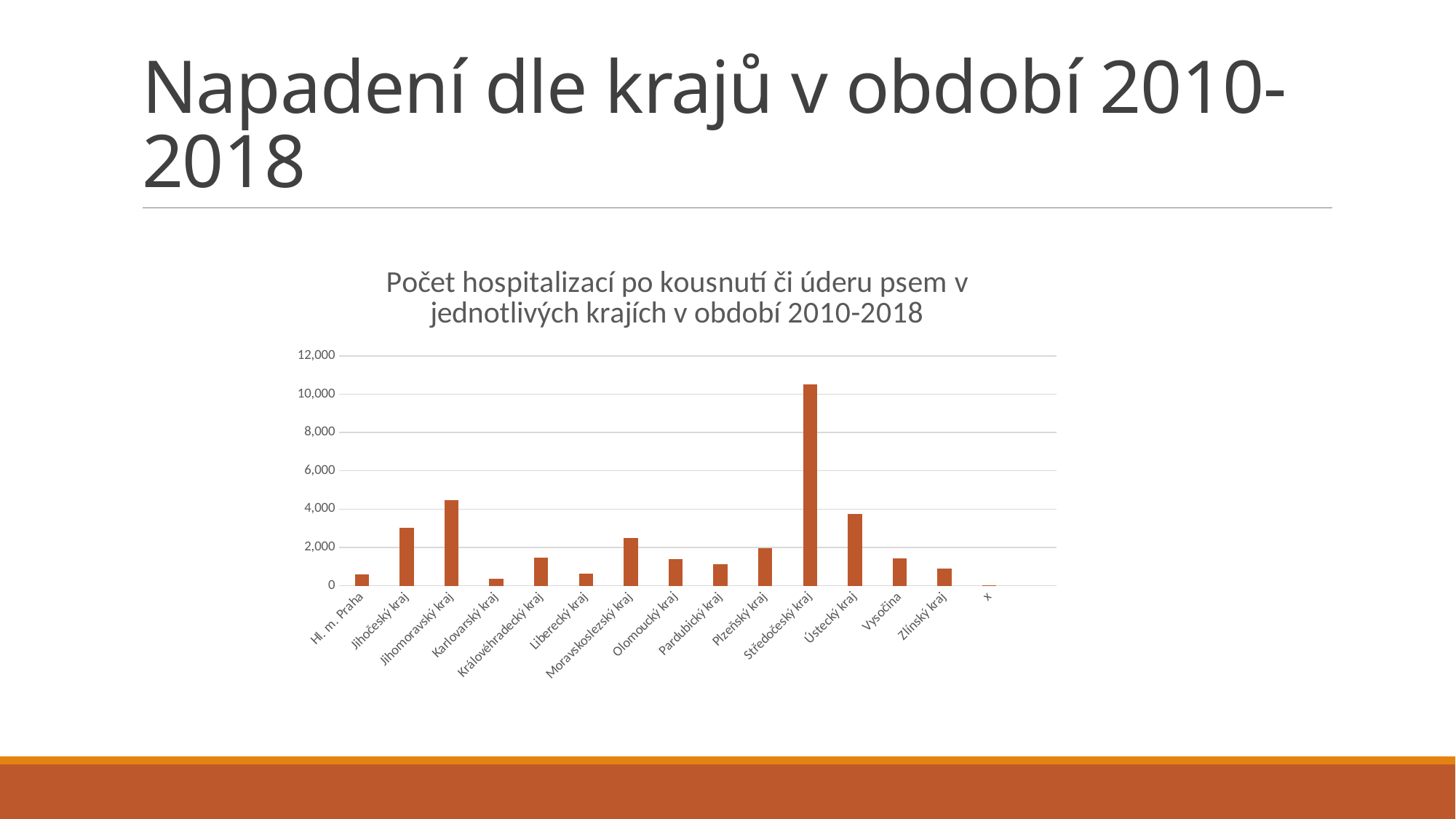
Is the value for Olomoucký kraj greater or less than 2,000? less What kind of chart is shown on the slide? bar chart Which category has the lowest value in the chart? x Which has a larger value, Ústecký kraj or Moravskoslezský kraj? Ústecký kraj How many categories are shown on the x axis of the chart? 15 Is the value for Karlovarský kraj greater or less than 2,000? less Is the value for Jihočeský kraj greater or less than 2,000? greater What is the title of the chart? Počet hospitalizací po kousnutí či úderu psem v jednotlivých krajích v období 2010-2018 Which category has the highest value in the chart? Středočeský kraj Which has a larger value, Jihomoravský kraj or Jihočeský kraj? Jihomoravský kraj